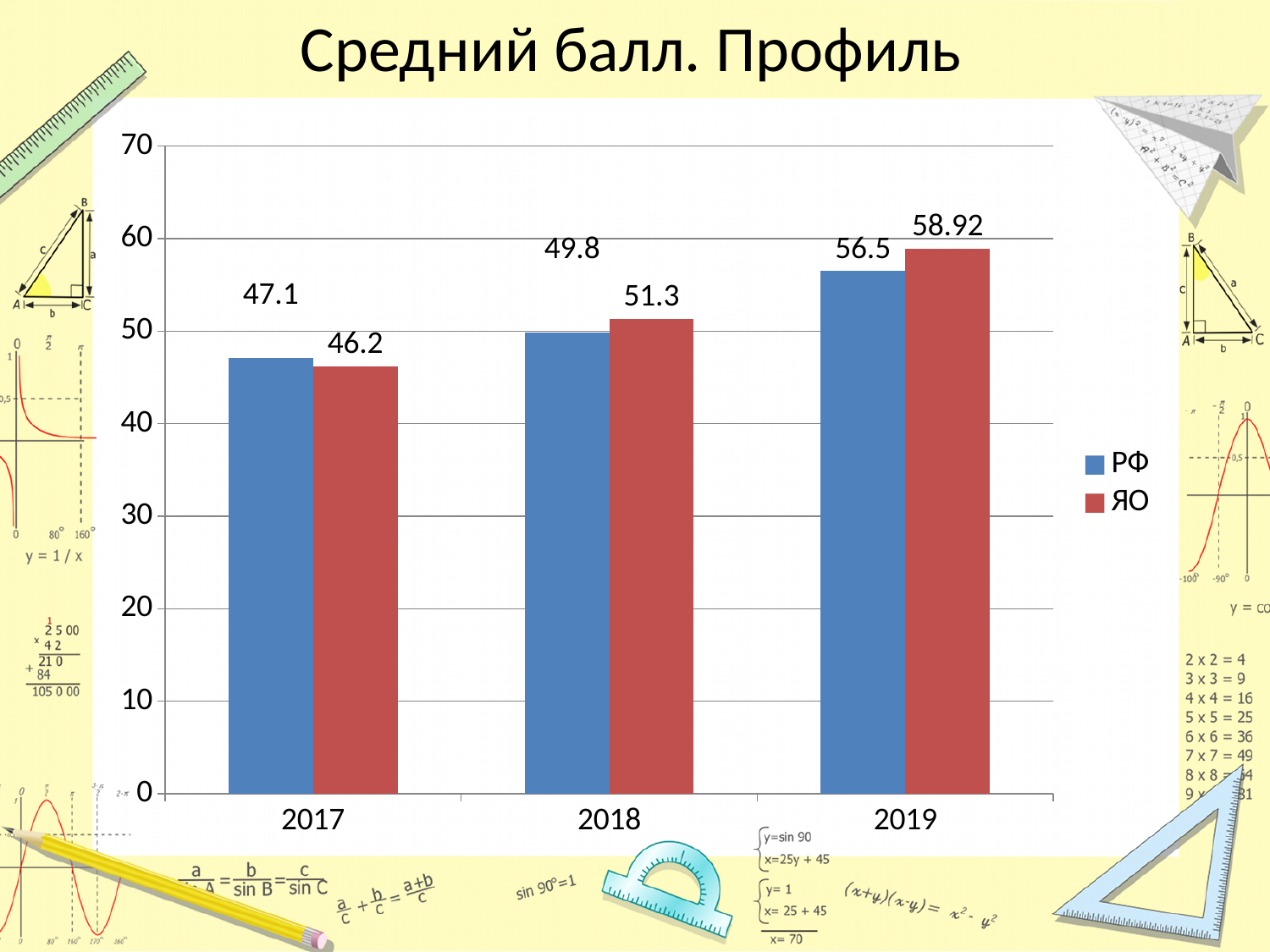
What is the value for РФ in 2017? 47.1 How many series does the legend list? 2 Which year has the lowest value for РФ? 2017 Which year has the highest value for ЯО? 2019 What is the value for ЯО in 2019? 58.92 How many years are shown on the x axis? 3 What is the value for ЯО in 2018? 51.3 What kind of chart is shown on the slide? bar chart What is the difference between РФ in 2018 and РФ in 2017? 2.7 Which is larger in 2017, РФ or ЯО? РФ Is the value for ЯО in 2018 greater or less than 50? greater What is the difference between ЯО and РФ in 2019? 2.42